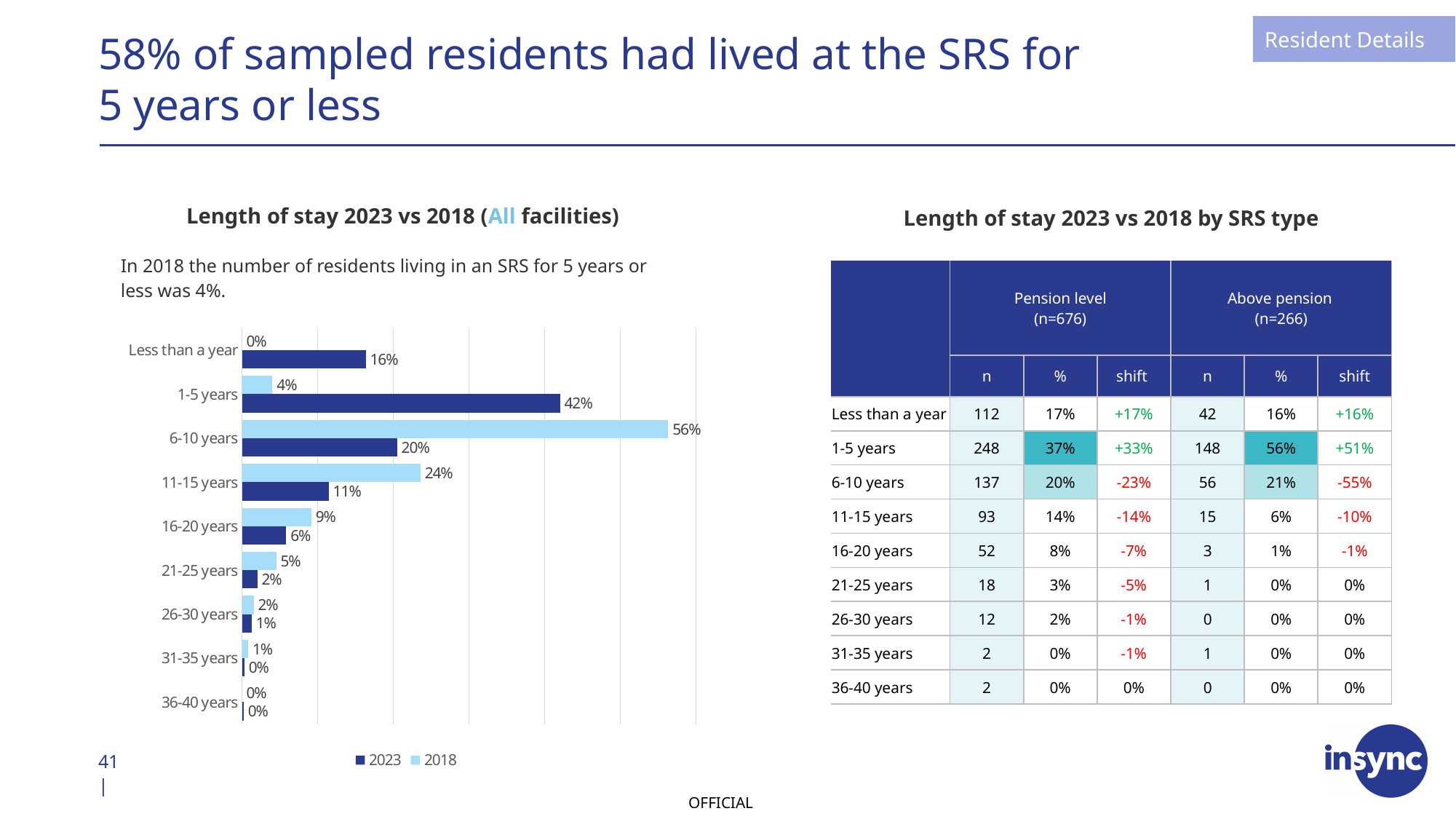
In the Length of stay chart, which is larger for 1-5 years: the 2023 value or the 2018 value? 2023 What type of chart is shown on the slide? bar chart How many length-of-stay categories are shown in the chart? 9 In the Length of stay chart, which category has the highest 2023 value? 1-5 years In the Length of stay chart, what is the 2023 value for 1-5 years? 42% In the Length of stay chart, what is the 2023 value for 11-15 years? 11% How many series does the chart legend list? 2 In the Length of stay chart, which category has the highest 2018 value? 6-10 years What is the title of the chart on the left of the slide? Length of stay 2023 vs 2018 (All facilities) In the Length of stay chart, what is the difference between the 2018 and 2023 values for 6-10 years? 36% In the Length of stay chart, what is the 2018 value for 16-20 years? 9% In the Length of stay chart, what is the 2018 value for 6-10 years? 56%